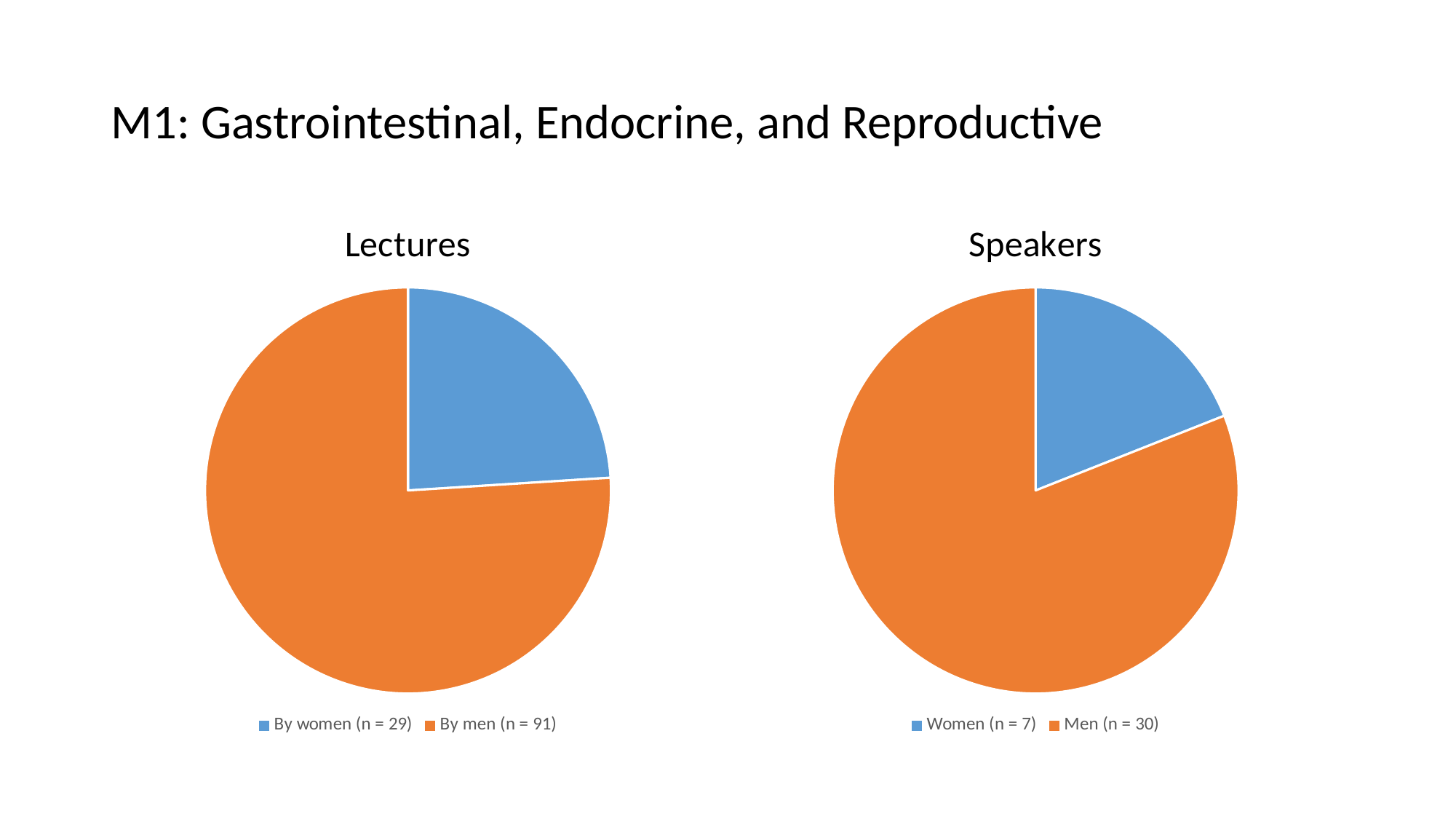
On the Speakers chart, which category has the smaller slice? Women (n = 7) On the Lectures chart, which category has the larger slice? By men (n = 91) How many categories does the Speakers chart show? 2 On the Lectures chart, how many lectures were given by men? 91 What kind of chart is the Lectures chart? Pie chart On the Speakers chart, what is the difference between the number of men and women speakers? 23 On the Lectures chart, what colour is the slice for lectures by women? Blue On the Lectures chart, how many lectures were given by women? 29 On the Lectures chart, what is the difference between the number of lectures by men and by women? 62 On the Speakers chart, how many speakers were women? 7 On the Speakers chart, what is the total number of speakers across both categories? 37 On the Speakers chart, how many speakers were men? 30